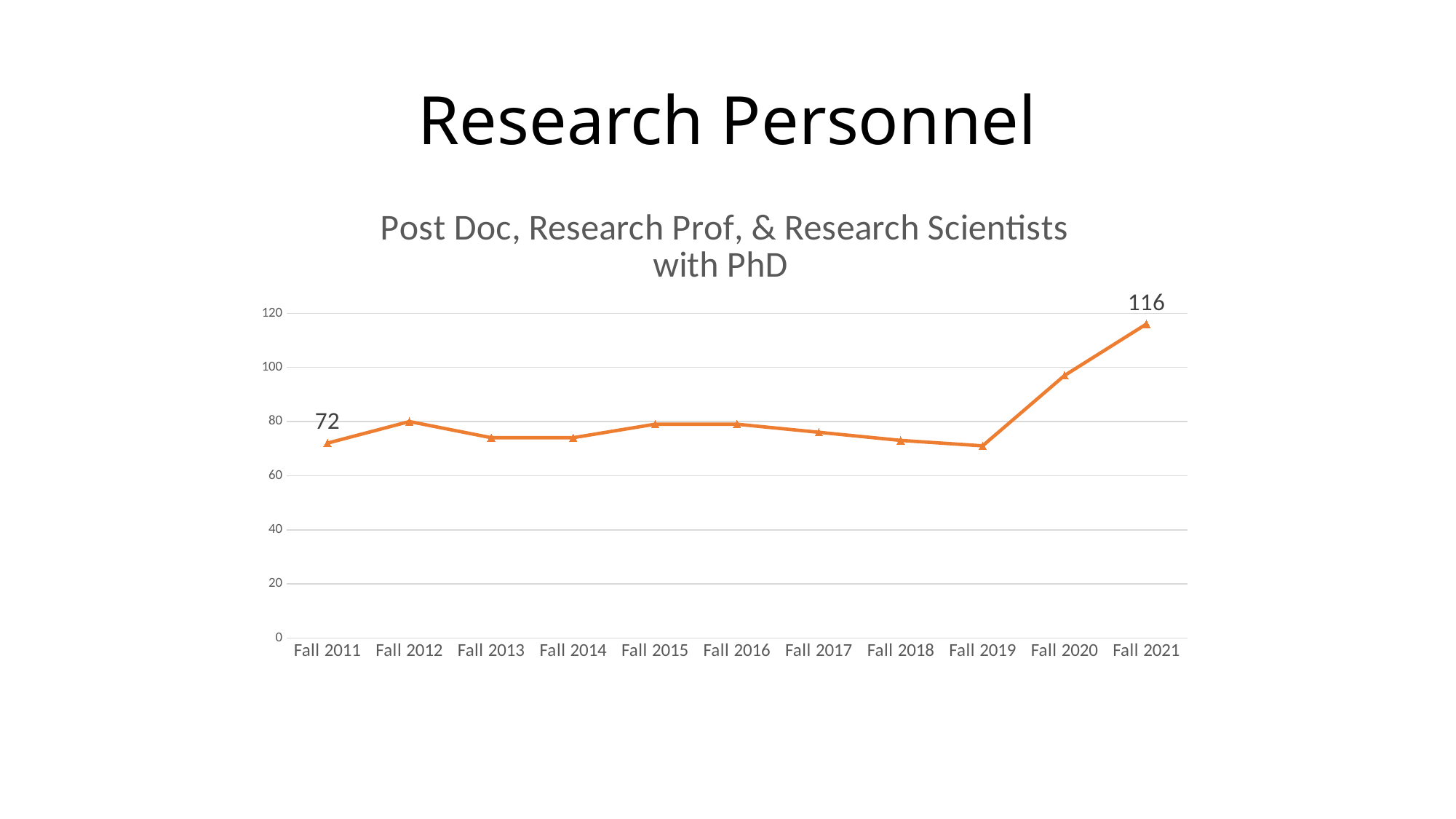
Do the values rise or fall from Fall 2019 to Fall 2021? rise Which is larger, the value for Fall 2020 or the value for Fall 2019? Fall 2020 What is the value for Fall 2021? 116 What is the difference between the Fall 2021 value and the Fall 2011 value? 44 Is the value for Fall 2019 greater or less than 80? less What kind of chart is shown on the slide? line chart How many data points are plotted on the chart? 11 What is the title of the chart? Post Doc, Research Prof, & Research Scientists with PhD Is the value for Fall 2012 greater or less than 100? less Which year has the highest value? Fall 2021 What is the value for Fall 2011? 72 Is the value for Fall 2020 greater or less than 80? greater